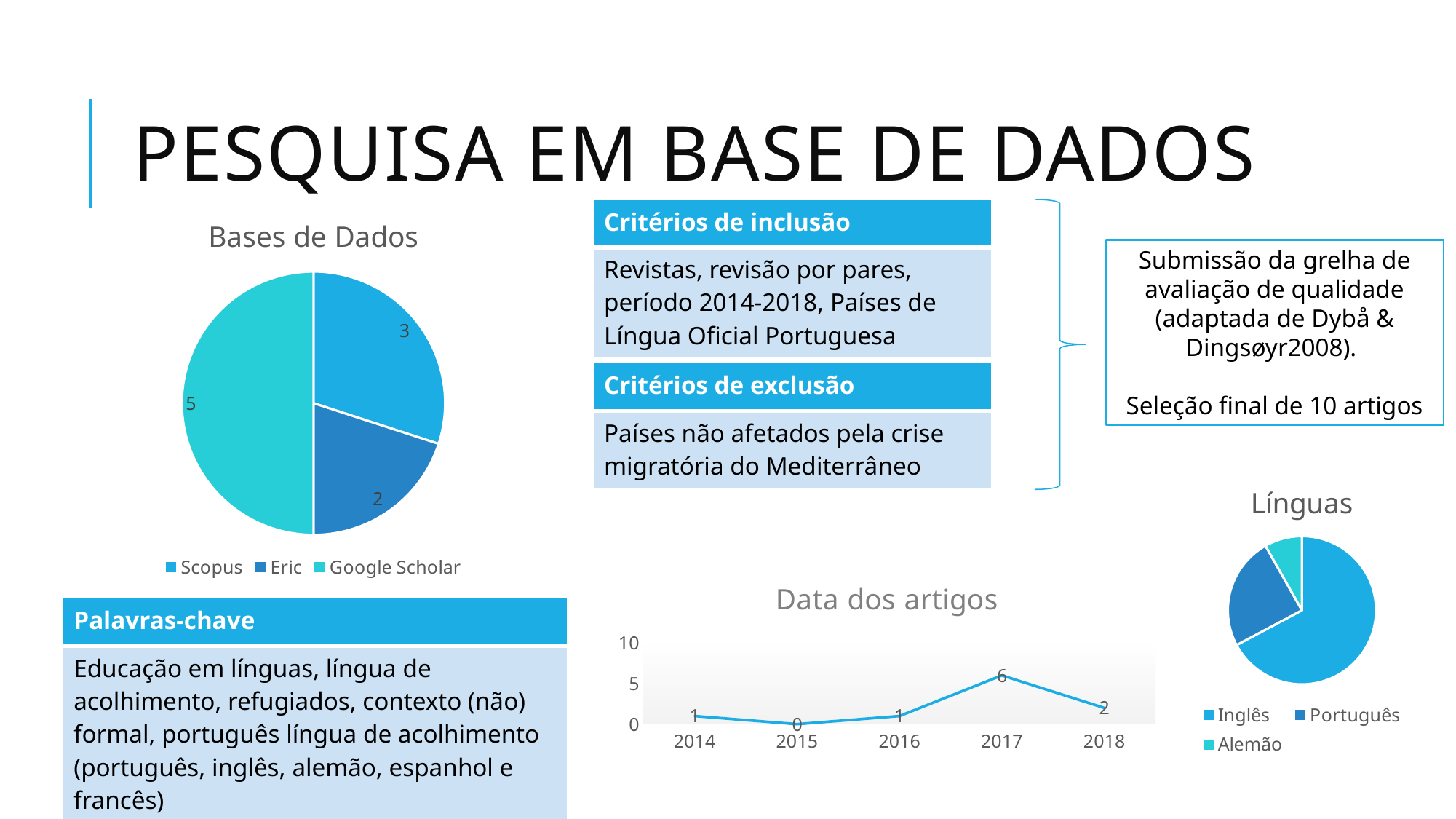
In the 'Bases de Dados' chart, which database has the largest slice? Google Scholar In the 'Bases de Dados' chart, what share of the total does Google Scholar represent? 50% In the 'Data dos artigos' chart, how many years are plotted on the x axis? 5 In the 'Línguas' chart, which language has the largest slice? Inglês How many entries does the legend of the 'Bases de Dados' chart list? 3 What kind of chart is 'Data dos artigos'? Line chart In the 'Bases de Dados' chart, what is the difference between the Google Scholar and Scopus values? 2 In the 'Data dos artigos' chart, which year has the lowest value? 2015 In the 'Data dos artigos' chart, is the value for 2017 greater or less than 5? greater In the 'Data dos artigos' chart, what is the value for 2017? 6 In the 'Bases de Dados' chart, what is the value for Eric? 2 In the 'Bases de Dados' chart, what is the value for Google Scholar? 5